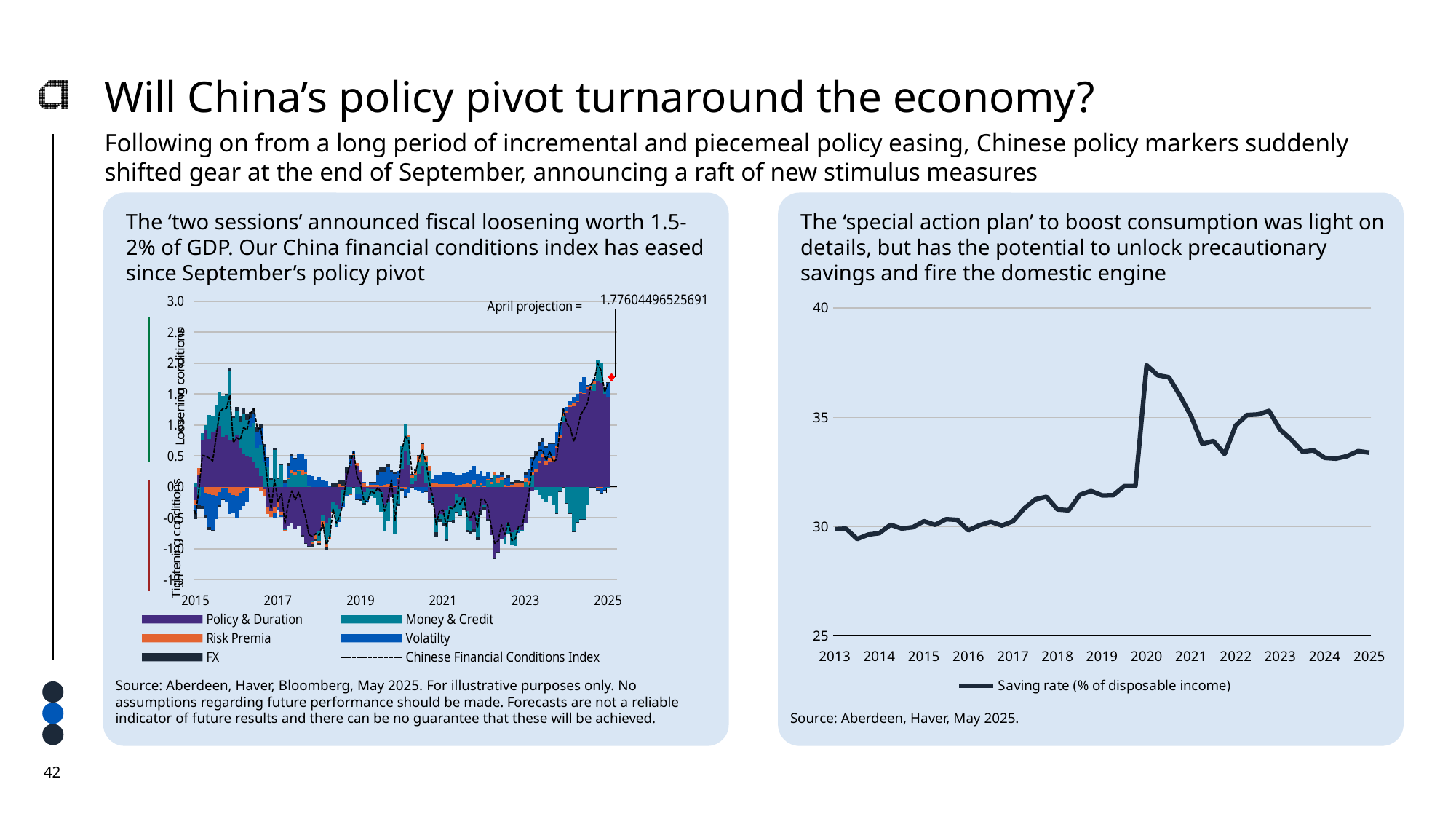
On the right-hand chart, how many series does the legend list? 1 On the right-hand chart, in which year does the saving rate reach its highest point? 2020 On the right-hand chart, is the saving rate in 2017 greater or less than 35? less On the left-hand chart, how many entries does the legend list? 6 On the right-hand chart, is the saving rate in 2025 greater or less than 30? greater What kind of chart is the right-hand chart showing the saving rate? Line chart On the left-hand chart, what is the April projection value printed on the chart? 1.77604496525691 On the left-hand chart, which series is drawn as a dashed line? Chinese Financial Conditions Index On the right-hand chart, is the saving rate in 2020 higher or lower than in 2015? Higher On the right-hand chart, what series does the legend list? Saving rate (% of disposable income) On the right-hand chart, is the saving rate in 2020 greater or less than 35? greater On the right-hand chart, does the saving rate rise or fall between 2020 and 2025? Fall